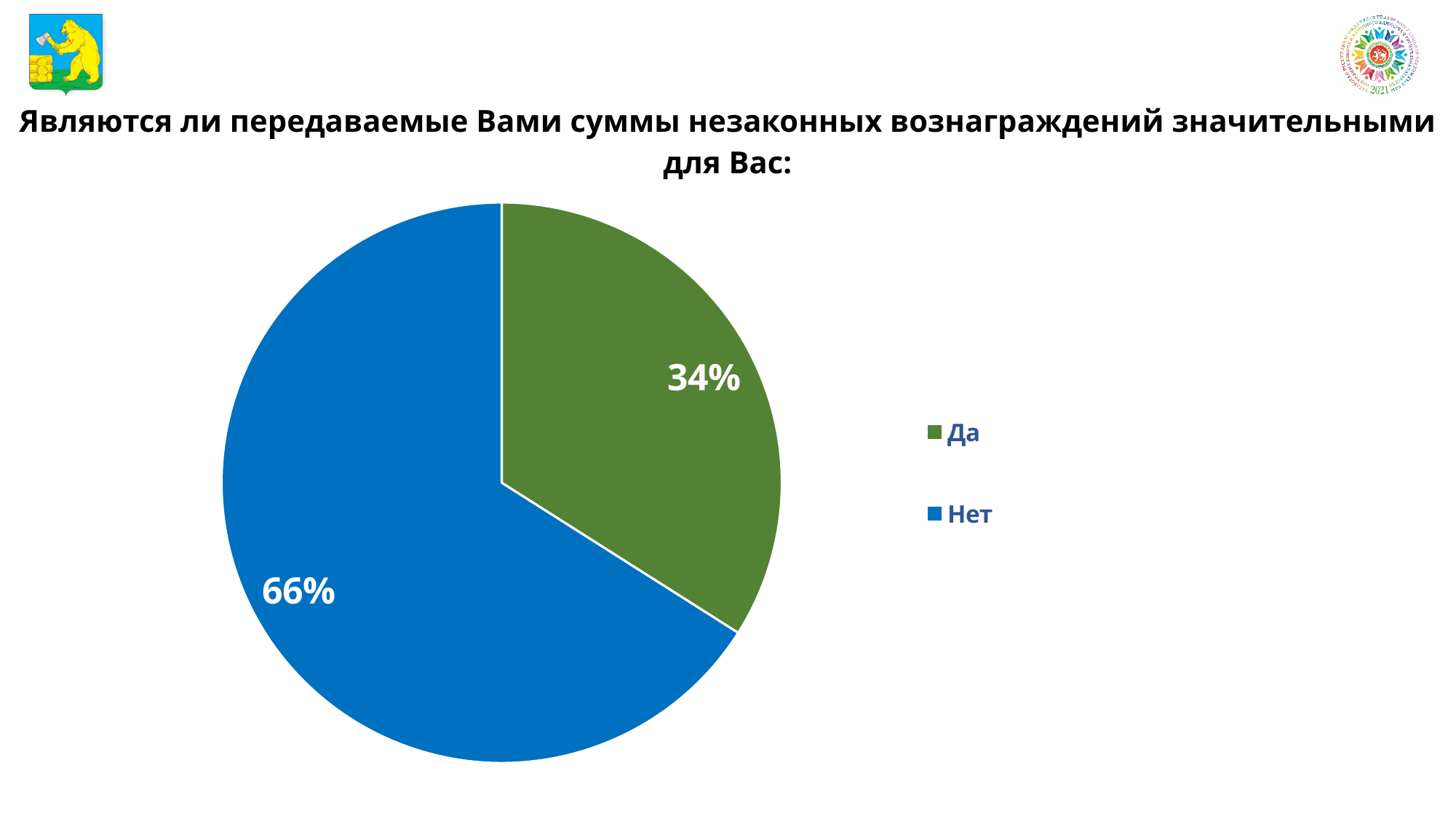
What colour is the "Да" slice? green What is the difference in percentage points between the "Нет" slice and the "Да" slice? 32 What kind of chart is shown on the slide? pie chart What percentage of the pie is labelled "Да"? 34% What colour is the "Нет" slice? blue Which slice of the pie is the smallest? Да How many slices does the pie chart have? 2 What percentage of the pie is labelled "Нет"? 66% Which is larger, the "Да" slice or the "Нет" slice? Нет What share of the pie does the "Нет" slice take? 66% Which slice of the pie is the largest? Нет How many entries does the legend list? 2